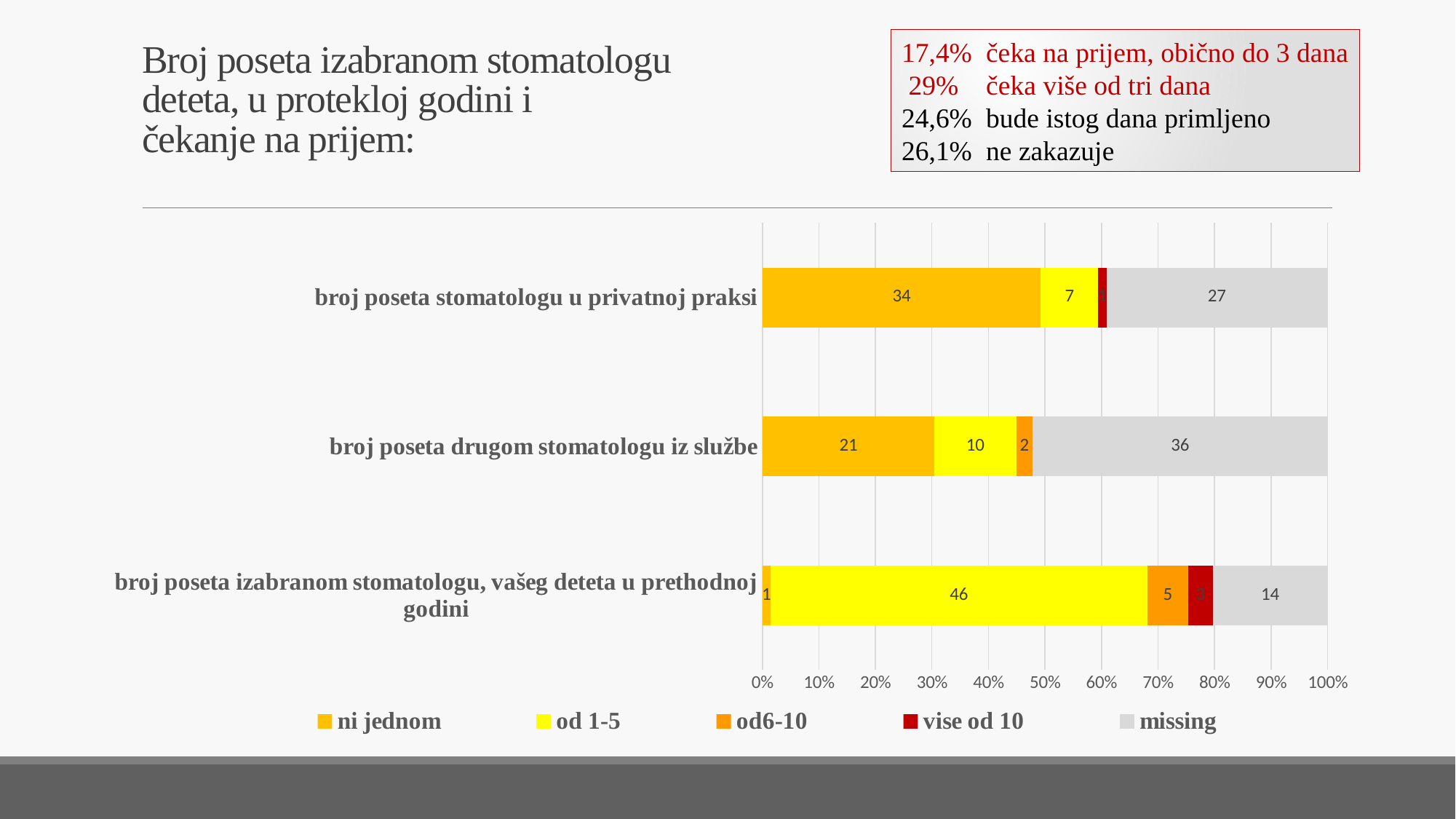
What is the value of 'ni jednom' for 'broj poseta stomatologu u privatnoj praksi'? 34 What is the difference between the 'ni jednom' values for 'broj poseta stomatologu u privatnoj praksi' and 'broj poseta drugom stomatologu iz službe'? 13 How many categories (bars) are plotted in the chart? 3 Which category has the lowest 'ni jednom' value? broj poseta izabranom stomatologu, vašeg deteta u prethodnoj godini What is the value of 'od6-10' for 'broj poseta drugom stomatologu iz službe'? 2 How many series does the legend list? 5 What is the value of 'missing' for 'broj poseta drugom stomatologu iz službe'? 36 What kind of chart is shown on the slide? stacked bar chart What is the value of 'od 1-5' for 'broj poseta izabranom stomatologu, vašeg deteta u prethodnoj godini'? 46 Which category has the highest 'missing' value? broj poseta drugom stomatologu iz službe Which is larger: the 'od 1-5' value for 'broj poseta drugom stomatologu iz službe' or for 'broj poseta stomatologu u privatnoj praksi'? broj poseta drugom stomatologu iz službe What is the total of the labelled segments in the bar for 'broj poseta izabranom stomatologu, vašeg deteta u prethodnoj godini'? 69